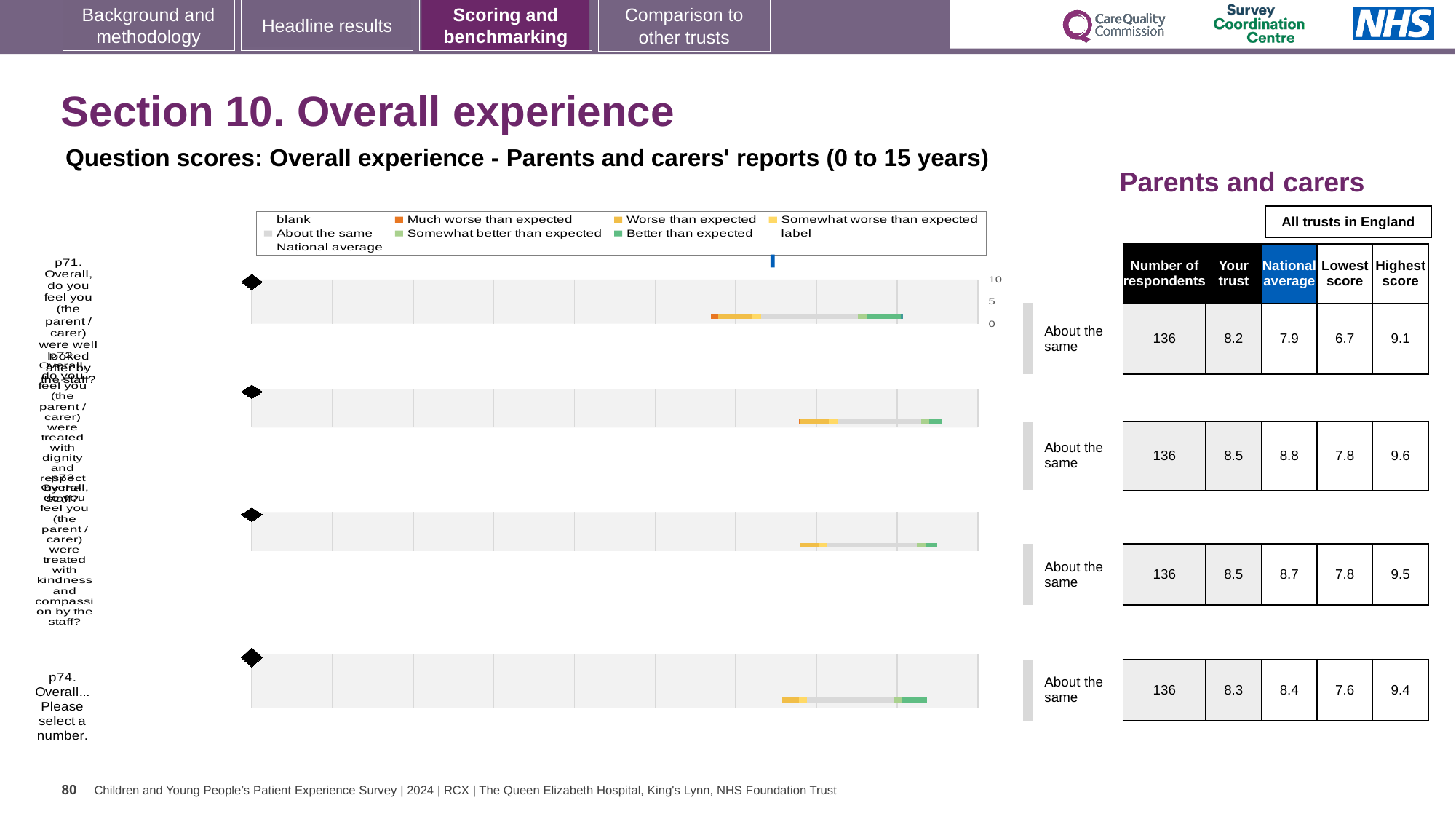
How many entries does the chart legend list? 9 For p72, which is larger: the 'Your trust' score or the National average? National average How many respondents are shown for p73 (treated with kindness and compassion)? 136 What kind of chart is used to show the question scores on this slide? bar chart How many question rows (categories) are plotted in the chart? 4 For p71, what is the difference between the 'Your trust' score and the National average? 0.3 What is the Highest score shown for p74 (Overall... Please select a number)? 9.4 Which question has the lowest 'Your trust' score? p71 What is the 'Your trust' score for p71 (Overall, do you feel you were well looked after by the staff?)? 8.2 Which question has the highest National average score? p72 What is the National average score for p72 (treated with dignity and respect)? 8.8 What benchmark category is shown for p74? About the same